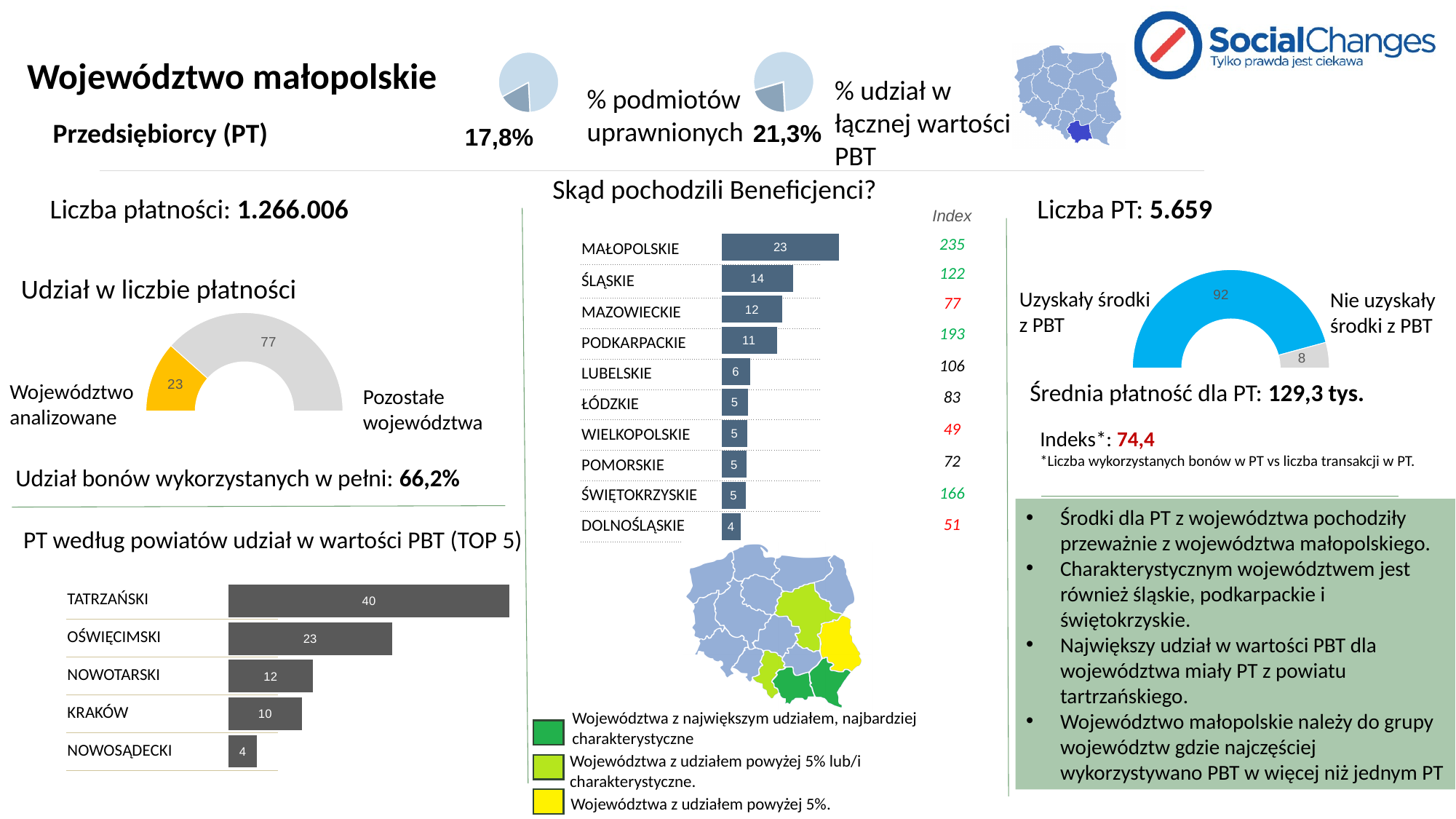
In the 'Skąd pochodzili Beneficjenci?' chart, how many voivodeships are listed? 10 What kind of chart is 'PT według powiatów udział w wartości PBT (TOP 5)'? bar chart In the 'Skąd pochodzili Beneficjenci?' chart, what is the difference between the values for ŚLĄSKIE and MAZOWIECKIE? 2 In the 'Skąd pochodzili Beneficjenci?' chart, what is the value for MAŁOPOLSKIE? 23 In the 'PT według powiatów udział w wartości PBT (TOP 5)' chart, what is the value for OŚWIĘCIMSKI? 23 In the 'PT według powiatów udział w wartości PBT (TOP 5)' chart, which is larger: NOWOTARSKI or KRAKÓW? NOWOTARSKI In the 'PT według powiatów udział w wartości PBT (TOP 5)' chart, which powiat has the highest value? TATRZAŃSKI In the chart next to 'Liczba PT: 5.659', what is the value for 'Nie uzyskały środki z PBT'? 8 In the 'Udział w liczbie płatności' chart, what is the value for 'Województwo analizowane'? 23 In the 'PT według powiatów udział w wartości PBT (TOP 5)' chart, what is the difference between TATRZAŃSKI and NOWOSĄDECKI? 36 In the 'Skąd pochodzili Beneficjenci?' chart, which voivodeship has the lowest value? DOLNOŚLĄSKIE In the 'Skąd pochodzili Beneficjenci?' chart, which voivodeship has the highest value? MAŁOPOLSKIE